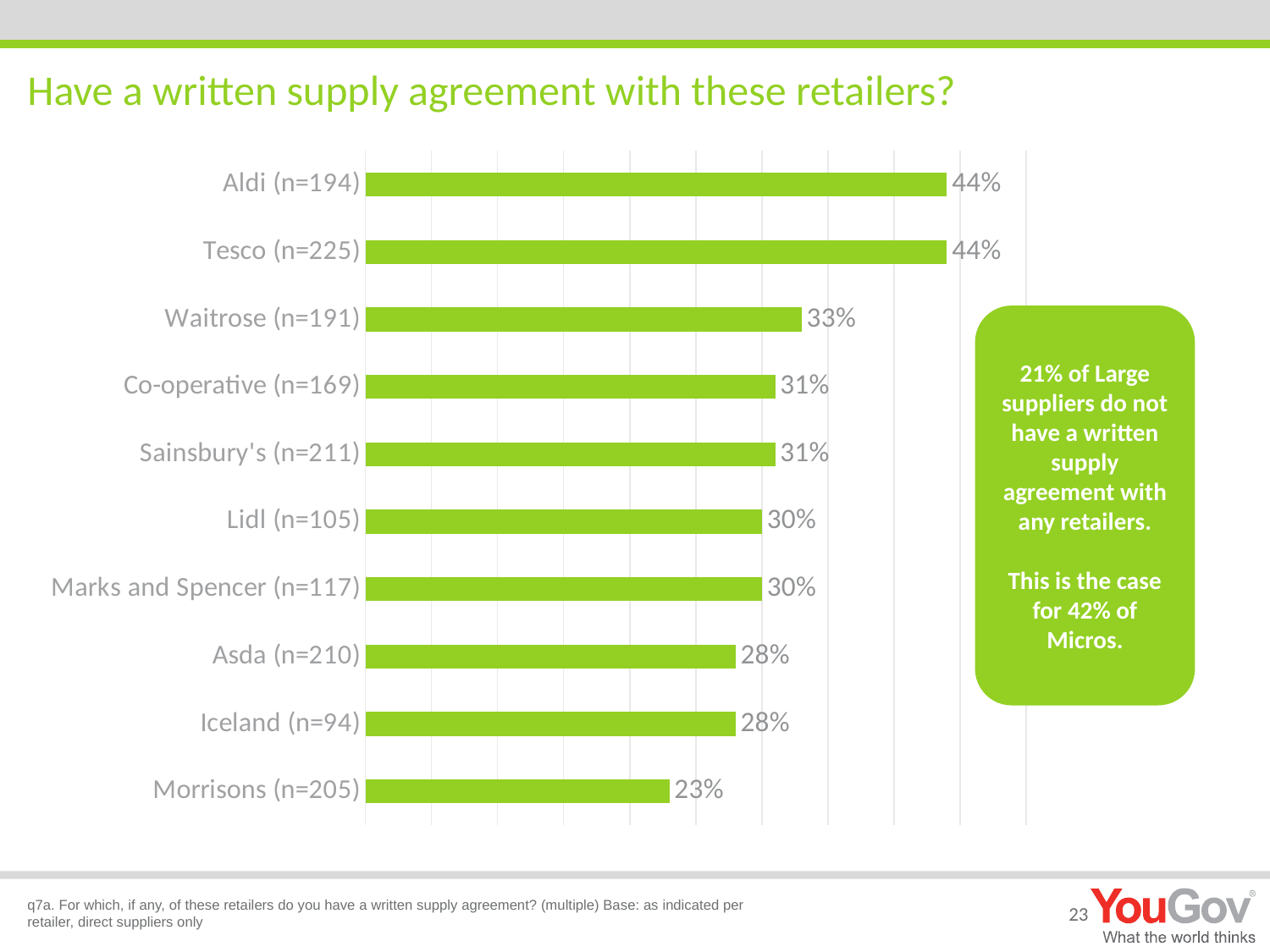
What is the difference between the values for Waitrose and Asda? 5% What is the sample size (n) shown for Tesco? 225 What is the value shown for Lidl (n=105)? 30% What percentage of Waitrose suppliers have a written supply agreement? 33% What is the title of the slide? Have a written supply agreement with these retailers? What is the difference between the values for Aldi and Morrisons? 21% Which retailer has the lowest percentage of suppliers with a written supply agreement? Morrisons (n=205) What type of chart is shown on the slide? Bar chart Which is larger, the value for Co-operative or the value for Iceland? Co-operative Which is larger, the value for Tesco or the value for Waitrose? Tesco What is the value shown for Morrisons (n=205)? 23% How many retailers are shown in the chart? 10